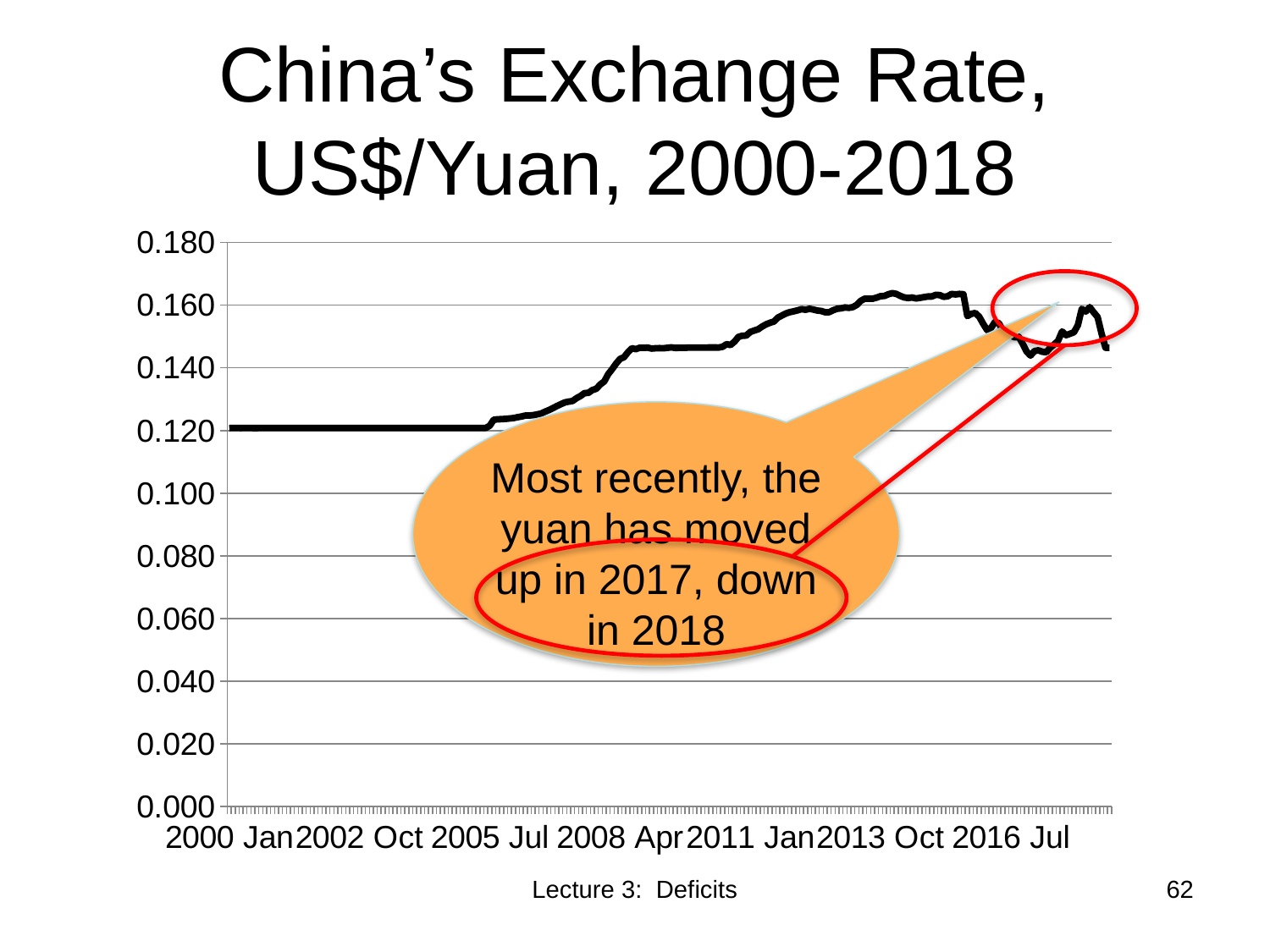
Is the exchange rate at 2000 Jan greater or less than 0.100? greater What kind of chart is shown on the slide? line chart Overall, does the exchange rate rise or fall from 2000 to 2018 along the x axis? rise Is the exchange rate at 2011 Jan greater or less than 0.160? less How many date labels are shown along the x axis? 7 What is the highest value shown on the y axis? 0.180 Which is lower, the exchange rate at 2005 Jul or at 2011 Jan? 2005 Jul Which is higher, the exchange rate at 2002 Oct or at 2013 Oct? 2013 Oct Is the exchange rate at 2000 Jan greater or less than 0.140? less What is the title of the chart on the slide? China's Exchange Rate, US$/Yuan, 2000-2018